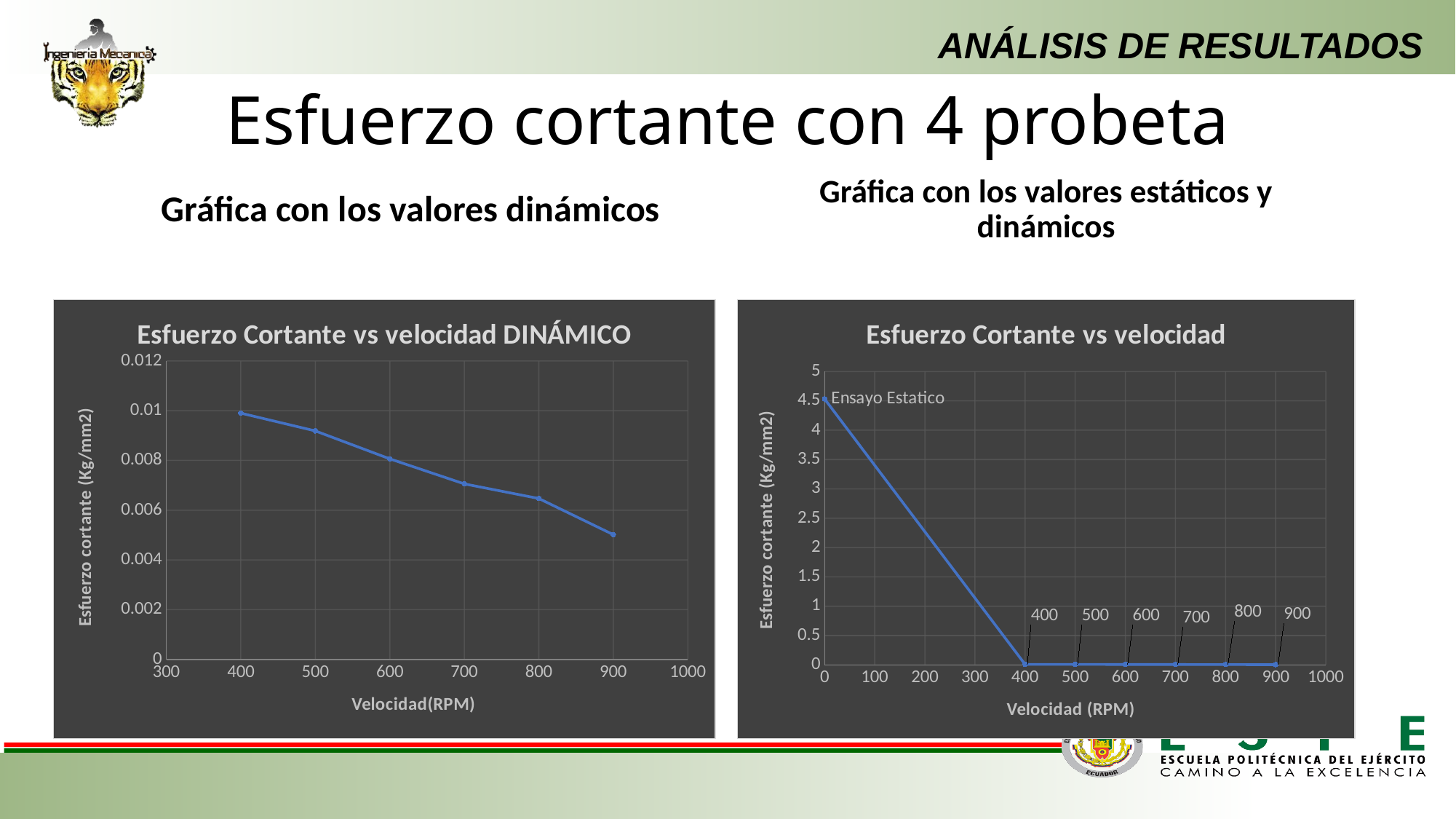
What kind of chart is the right chart titled 'Esfuerzo Cortante vs velocidad'? line chart In the left chart 'Esfuerzo Cortante vs velocidad DINÁMICO', is the value at 900 RPM greater or less than 0.006? less In the left chart 'Esfuerzo Cortante vs velocidad DINÁMICO', which is larger, the value at 500 RPM or the value at 800 RPM? 500 RPM What kind of chart is the left chart titled 'Esfuerzo Cortante vs velocidad DINÁMICO'? line chart In the left chart 'Esfuerzo Cortante vs velocidad DINÁMICO', at which velocity (RPM) is the shear stress lowest? 900 In the right chart 'Esfuerzo Cortante vs velocidad', what is the label of the point at 0 RPM? Ensayo Estatico In the right chart 'Esfuerzo Cortante vs velocidad', is the value of the 'Ensayo Estatico' point greater or less than 4? greater In the left chart 'Esfuerzo Cortante vs velocidad DINÁMICO', at which velocity (RPM) is the shear stress highest? 400 In the left chart 'Esfuerzo Cortante vs velocidad DINÁMICO', how many data points are plotted? 6 In the left chart 'Esfuerzo Cortante vs velocidad DINÁMICO', do the values rise or fall as velocity increases from 400 to 900 RPM? fall In the left chart 'Esfuerzo Cortante vs velocidad DINÁMICO', is the value at 400 RPM greater or less than 0.008? greater What is the x-axis title of the left chart 'Esfuerzo Cortante vs velocidad DINÁMICO'? Velocidad(RPM)